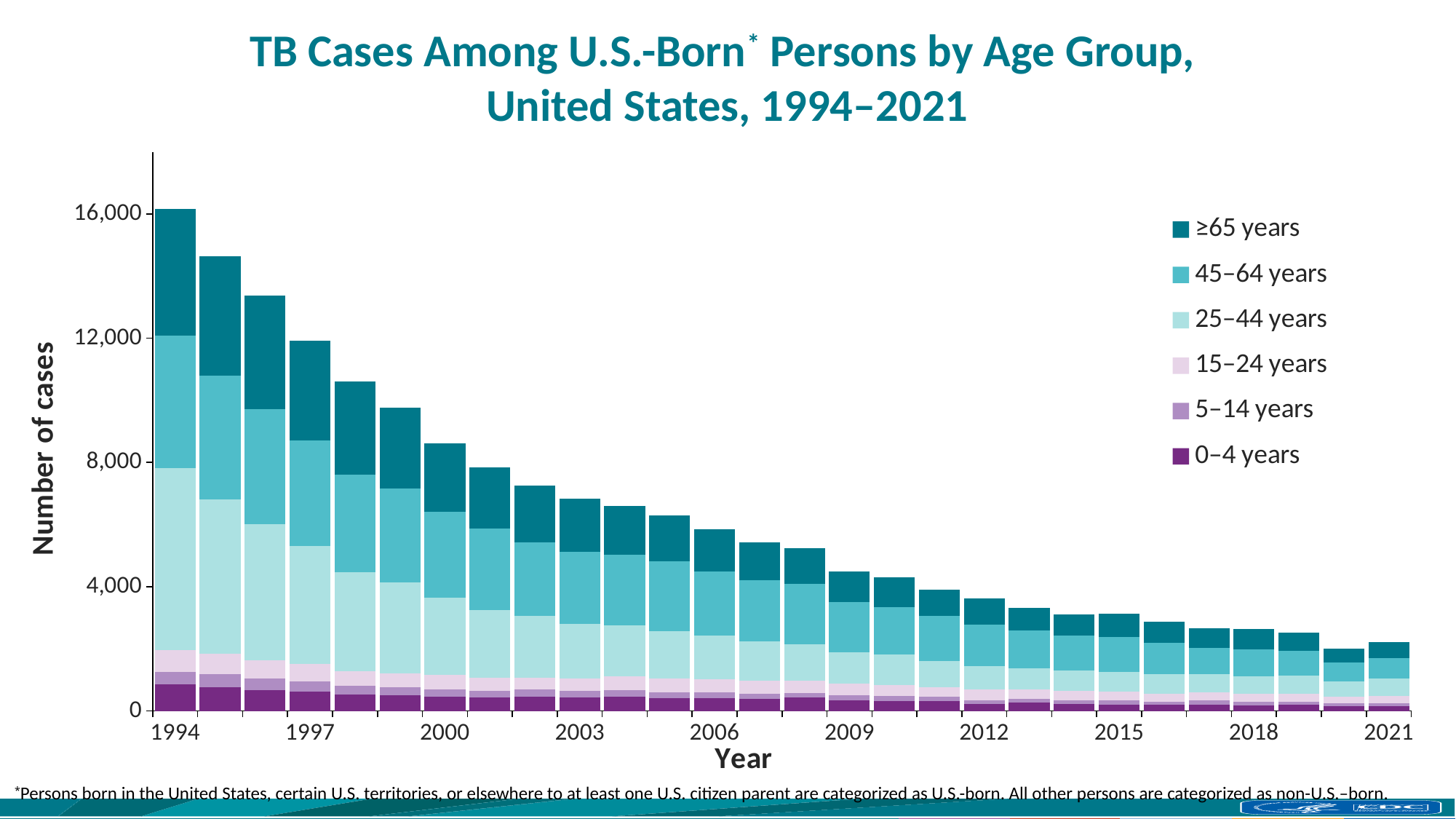
Is the total number of cases in 1994 greater or less than 12,000? greater Which year has a larger total number of cases, 2000 or 2010? 2000 Is the total number of cases in 2012 greater or less than 4,000? less How many years (bars) are plotted on the chart? 28 Do the total TB cases among U.S.-born persons rise or fall from 1994 to 2021? Fall How many series does the legend list? 6 Is the total number of cases in 2021 greater or less than 4,000? less Which year has the highest total number of TB cases among U.S.-born persons? 1994 What is the label on the vertical axis of the chart? Number of cases What kind of chart is shown on the slide? Stacked bar chart Which year has the lowest total number of TB cases among U.S.-born persons? 2020